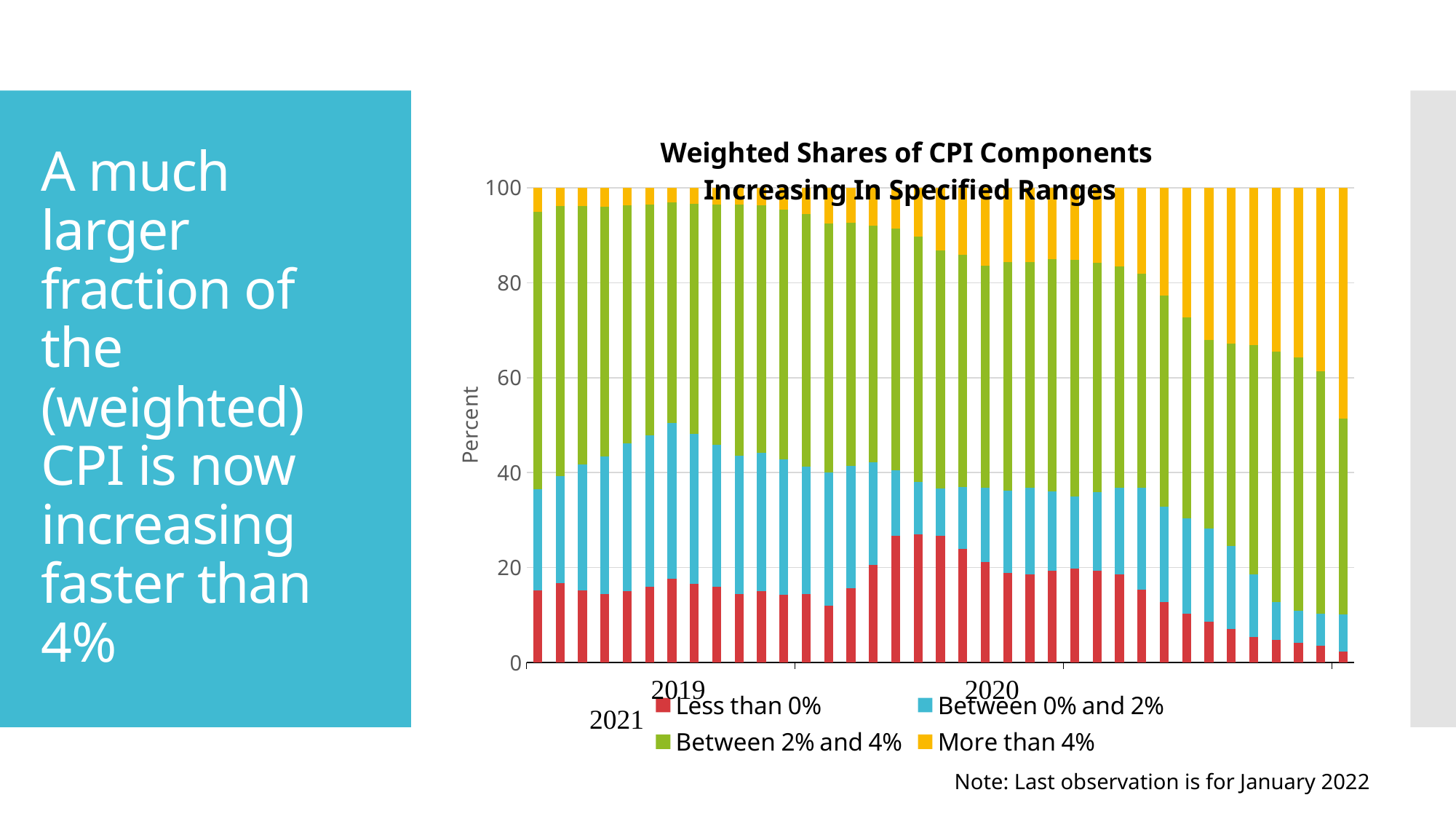
Does the 'More than 4%' share rise or fall moving from the left of the chart to the right? Rise Is the 'Less than 0%' value for the first bar on the left greater or less than 20? less Does the 'Less than 0%' share rise or fall over the last bars on the right of the chart? Fall What is the title of the chart? Weighted Shares of CPI Components Increasing In Specified Ranges What kind of chart is shown on the slide? Stacked bar chart Is the 'Less than 0%' value for the last bar on the right greater or less than 20? less What is the total height of each stacked bar in the chart? 100 In the last bar on the right, which is larger: the 'More than 4%' segment or the 'Less than 0%' segment? More than 4% How many series does the legend list? 4 In the first bar on the left, which is larger: the 'Between 2% and 4%' segment or the 'More than 4%' segment? Between 2% and 4% Which series is shown in yellow in the chart? More than 4% What is the label on the vertical axis of the chart? Percent